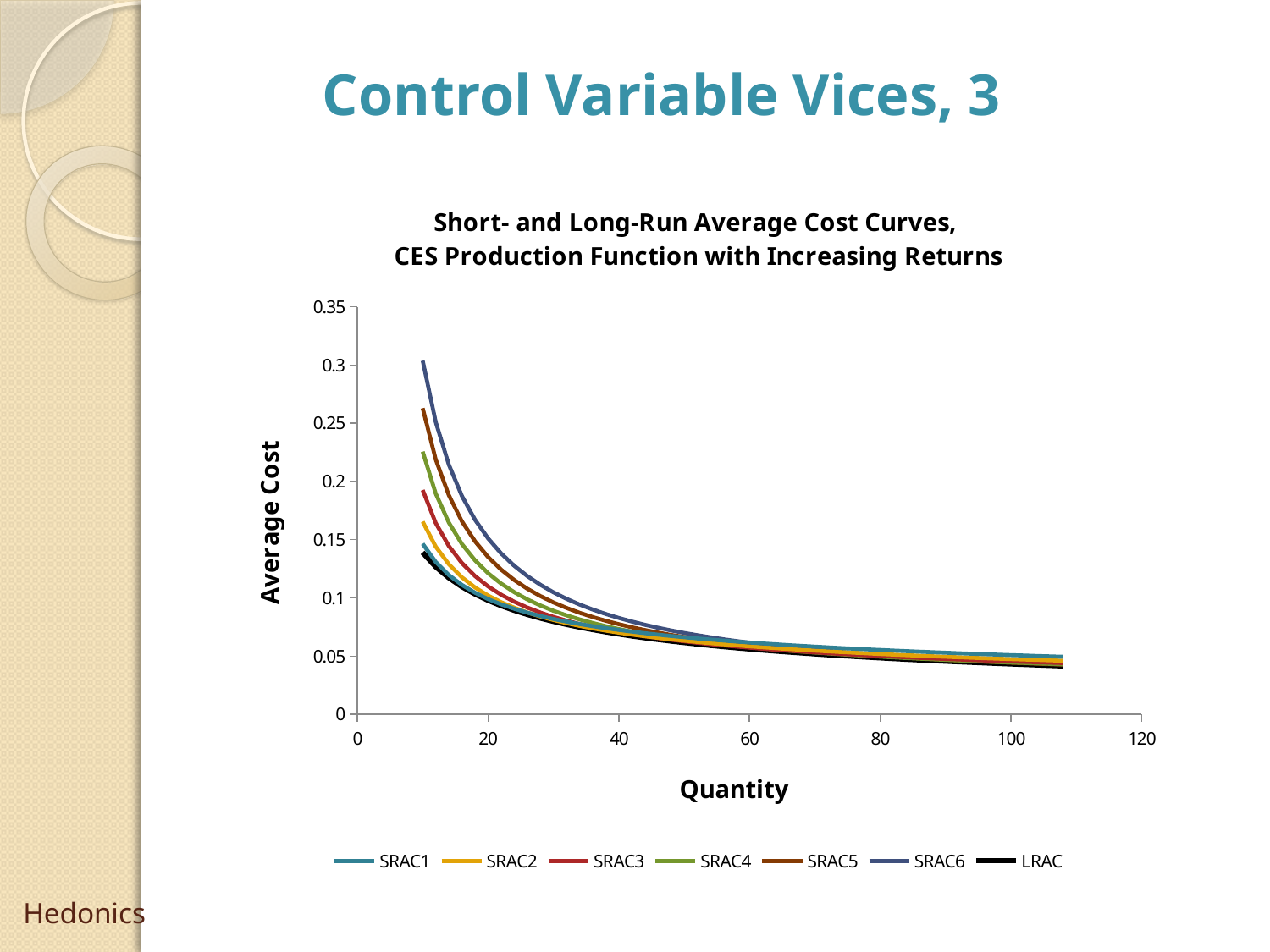
At quantity 100, are the average cost values greater or less than 0.1? less What kind of chart is shown on the slide? Line chart What is the label of the vertical axis? Average Cost Which series has the highest average cost at the left end of the chart (around quantity 10)? SRAC6 Is the starting value of SRAC1 (at the lowest quantity plotted) greater or less than 0.2? less Do the average cost curves rise or fall as quantity increases? Fall What is the title of the chart? Short- and Long-Run Average Cost Curves, CES Production Function with Increasing Returns What is the maximum value shown on the horizontal axis? 120 Is the starting value of SRAC6 (at the lowest quantity plotted) greater or less than 0.25? greater How many series does the legend list? 7 At the left end of the chart, which series has the higher average cost, SRAC5 or SRAC2? SRAC5 What is the maximum value shown on the vertical axis? 0.35